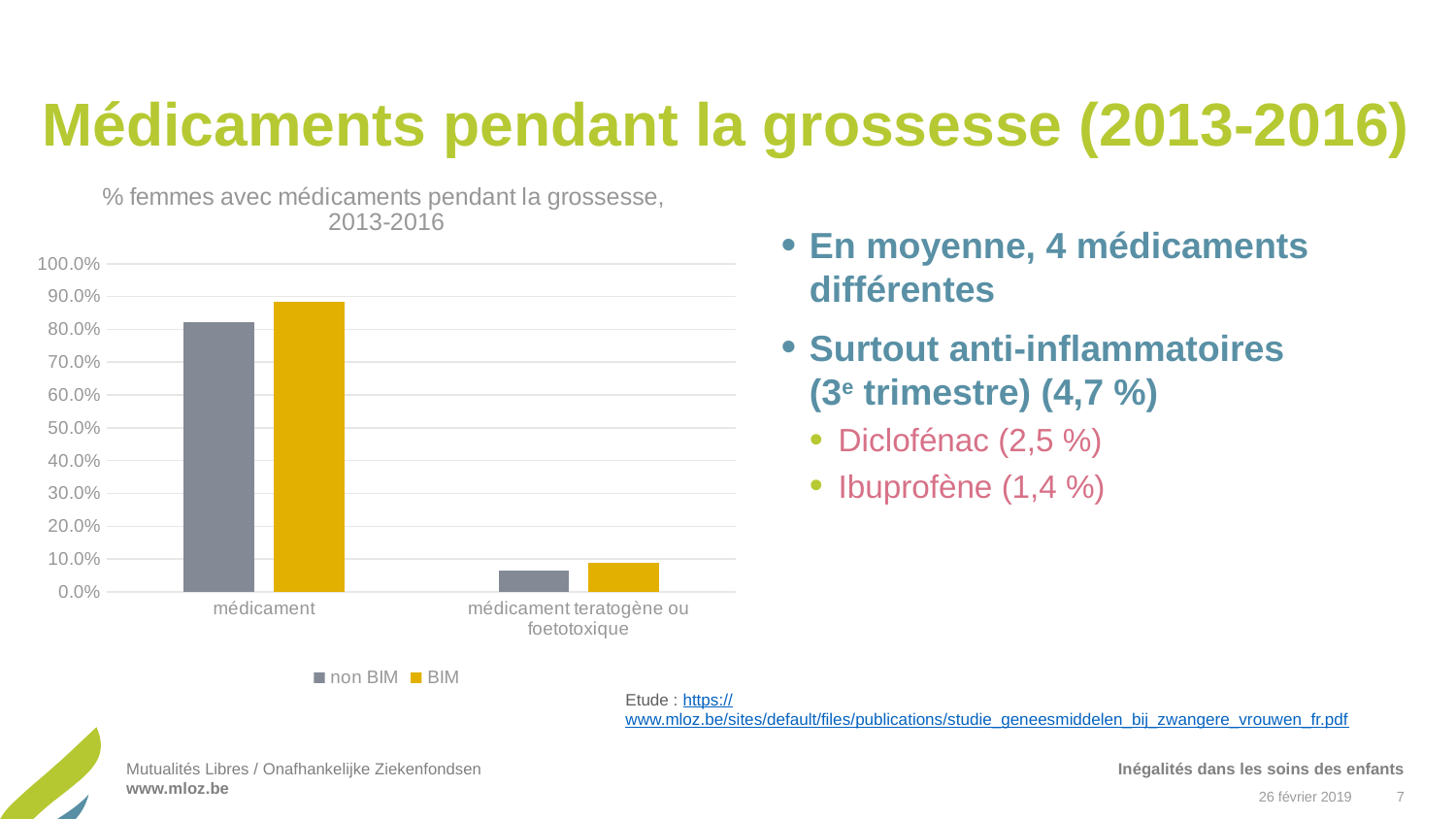
What are the two series named in the legend? non BIM and BIM For the BIM series, which category has the highest value? médicament What kind of chart is shown on the slide? bar chart In the 'médicament' category, which series has the larger value, non BIM or BIM? BIM How many categories are shown on the x axis of the chart? 2 Is the value for BIM in the 'médicament' category greater or less than 80.0%? greater Is the value for BIM in the 'médicament teratogène ou foetotoxique' category greater or less than 20.0%? less How many series does the chart legend list? 2 Is the value for non BIM in the 'médicament' category greater or less than 70.0%? greater Which category has the lowest values for both series? médicament teratogène ou foetotoxique What is the title of the chart? % femmes avec médicaments pendant la grossesse, 2013-2016